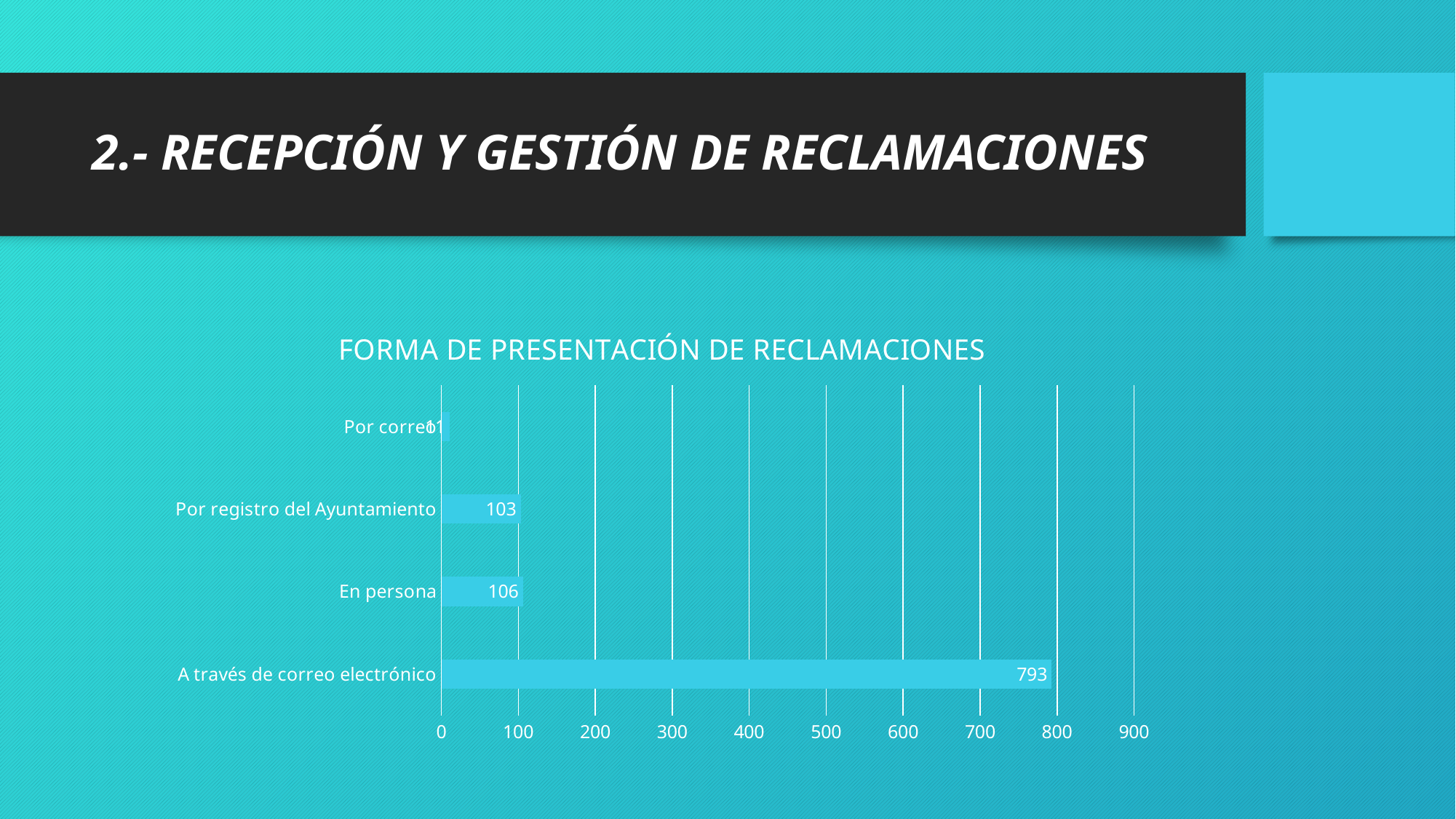
What is the value for 'A través de correo electrónico'? 793 Which category has the highest value? A través de correo electrónico What is the value for 'Por registro del Ayuntamiento'? 103 What type of chart is shown on the slide? bar chart What is the difference between 'En persona' and 'Por registro del Ayuntamiento'? 3 What is the difference between 'A través de correo electrónico' and 'En persona'? 687 How many categories does the chart show? 4 Which is larger, 'En persona' or 'Por registro del Ayuntamiento'? En persona What is the value for 'En persona'? 106 What is the title of the chart? FORMA DE PRESENTACIÓN DE RECLAMACIONES Which category has the lowest value? Por correo Is the value for 'Por correo' greater or less than 100? less